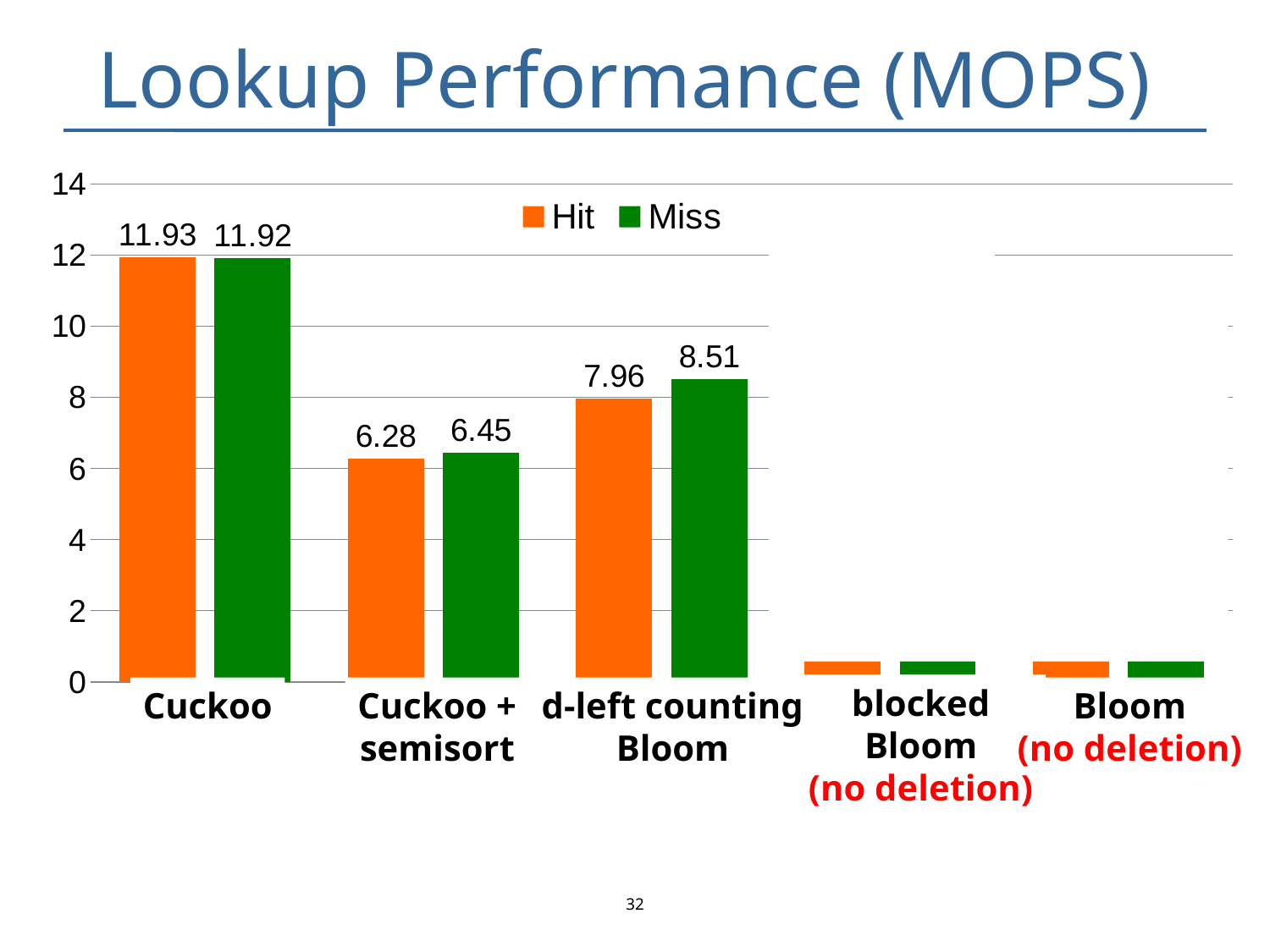
Which is larger, the Hit value for Cuckoo + semisort or the Hit value for d-left counting Bloom? d-left counting Bloom What kind of chart is shown on the slide? bar chart How many categories are shown on the x axis? 5 What is the Hit value for Cuckoo? 11.93 What is the Hit value for d-left counting Bloom? 7.96 What is the difference between the Miss and Hit values for d-left counting Bloom? 0.55 Is the Miss value for Cuckoo greater or less than 10? greater Which category has the highest Hit value? Cuckoo How many series does the legend list? 2 What is the Miss value for Cuckoo + semisort? 6.45 What is the Miss value for d-left counting Bloom? 8.51 Among Cuckoo, Cuckoo + semisort and d-left counting Bloom, which has the lowest Miss value? Cuckoo + semisort